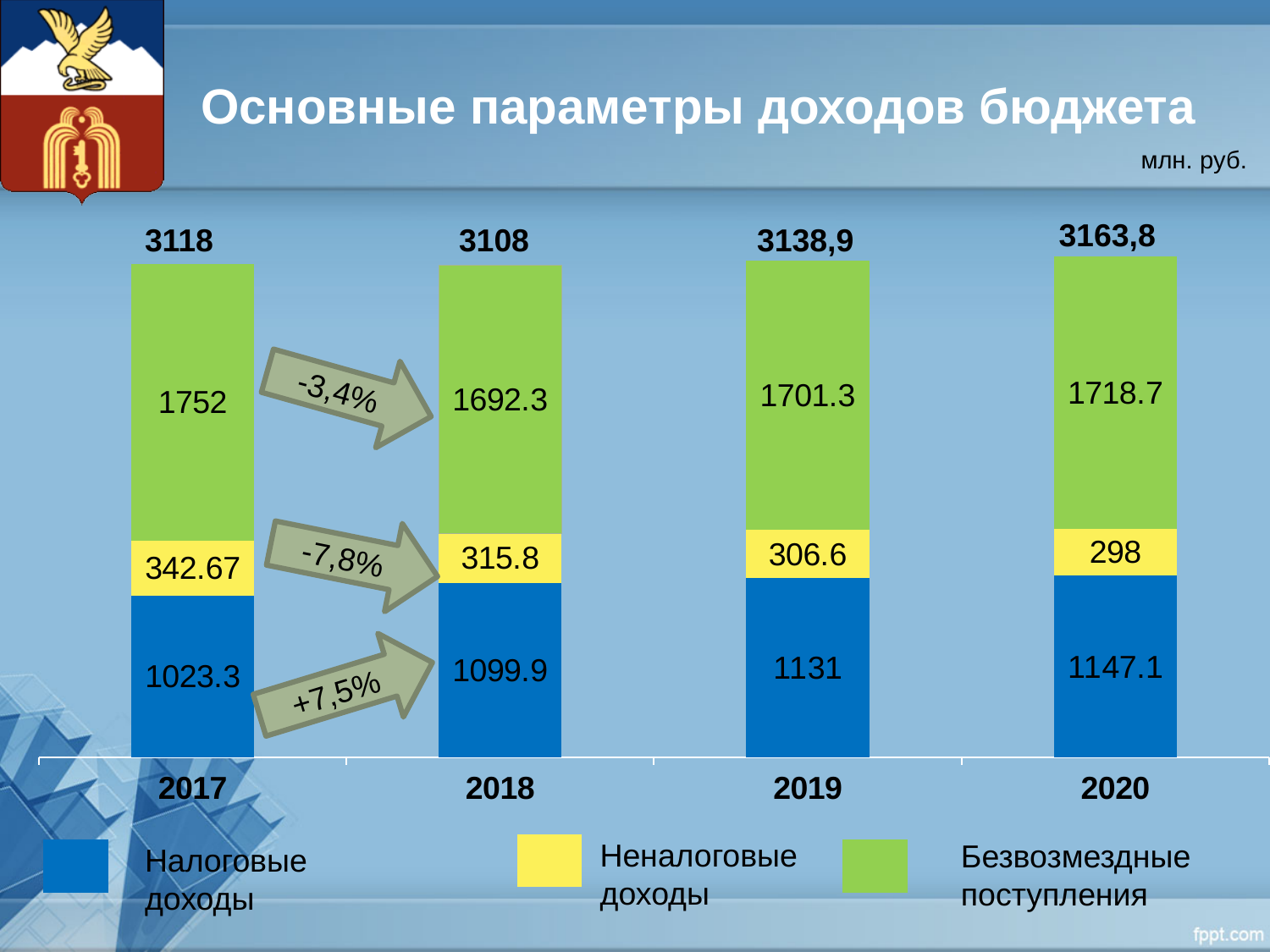
What is the total of the stacked bar for 2018? 3108 What is the value of Безвозмездные поступления for 2020? 1718.7 Do the values for Налоговые доходы rise or fall from 2017 to 2020? Rise What kind of chart is shown on the slide? Stacked bar chart Which year has the larger value for Неналоговые доходы, 2018 or 2019? 2018 What is the difference between Налоговые доходы in 2020 and in 2017? 123.8 Which year has the highest total budget income? 2020 What is the value of Налоговые доходы for 2019? 1131 How many series does the legend list? 3 How many years are shown on the x axis? 4 Which year has the lowest total budget income? 2018 What is the value of Неналоговые доходы for 2017? 342.67